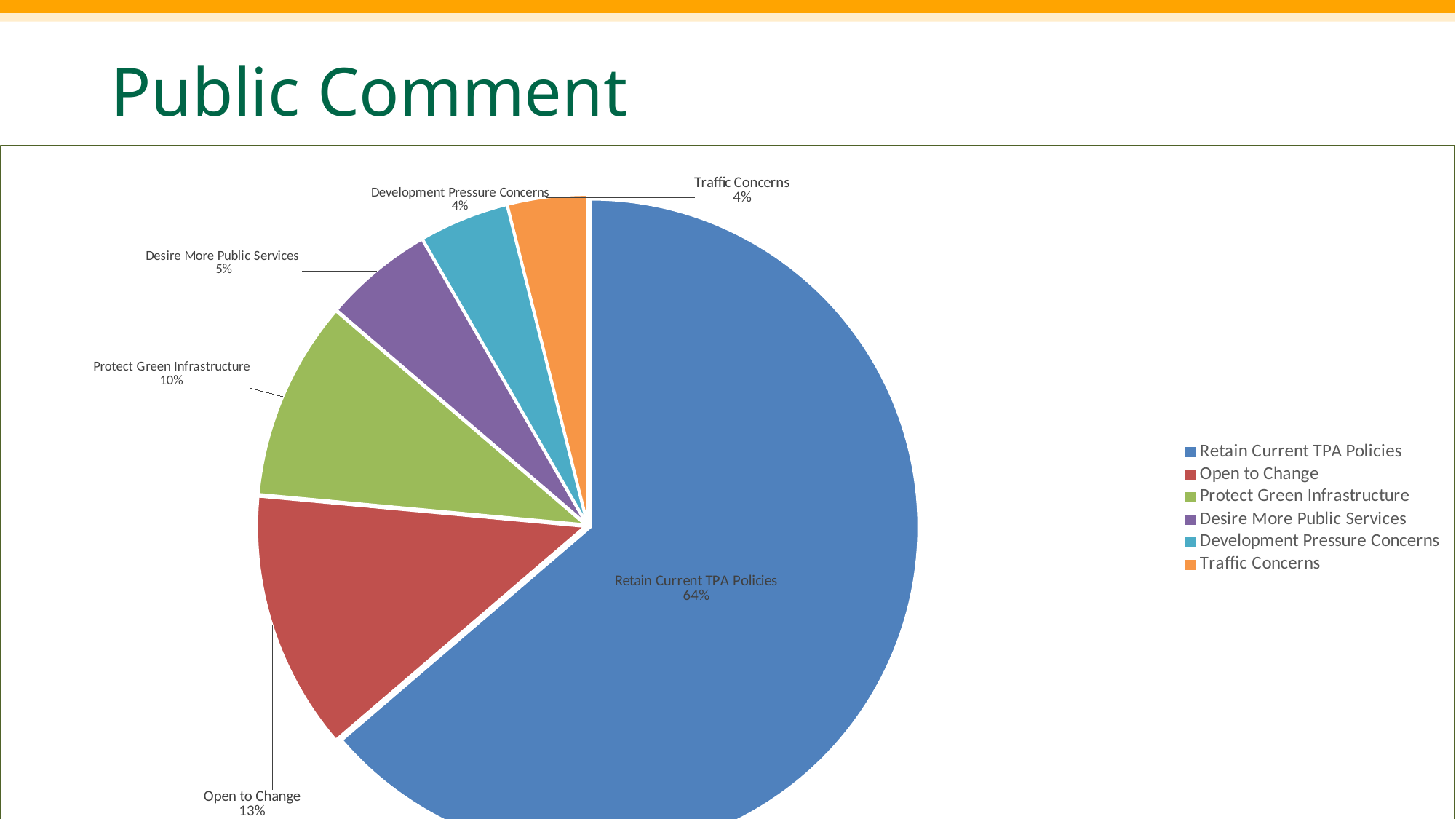
What is the value shown for Desire More Public Services? 5% What is the difference between the Open to Change share and the Protect Green Infrastructure share? 3% How many categories are shown in the pie chart? 6 Which category has the largest slice of the pie? Retain Current TPA Policies Which is larger, Protect Green Infrastructure or Desire More Public Services? Protect Green Infrastructure What is the value shown for Open to Change? 13% What kind of chart is shown on the slide? pie chart What colour is the Traffic Concerns slice? orange How many entries does the legend list? 6 What share of the pie does Retain Current TPA Policies represent? 64% What is the difference between the Retain Current TPA Policies share and the Open to Change share? 51% What is the value shown for Protect Green Infrastructure? 10%